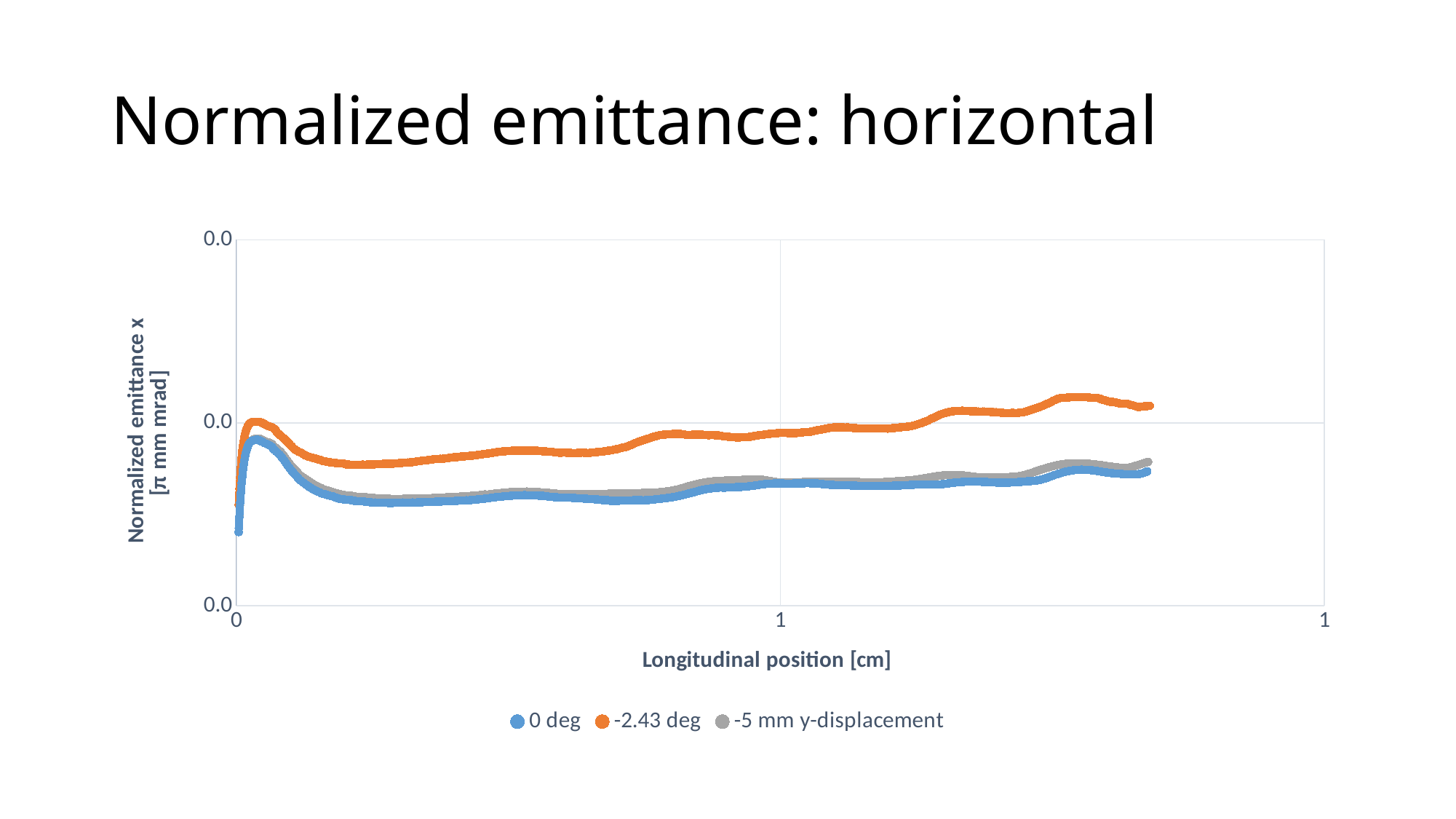
What is the x-axis title of the chart? Longitudinal position [cm] Which series has the highest values across the plotted range? -2.43 deg What is the title of the chart? Normalized emittance: horizontal What kind of chart is shown on the slide? Line chart Which series is higher over most of the plotted range, 0 deg or -2.43 deg? -2.43 deg Which series is higher at the right end of the chart, -2.43 deg or -5 mm y-displacement? -2.43 deg After the initial dip, do the values of the 0 deg series generally rise or fall toward the right end of the chart? Rise After the initial dip, do the values of the -2.43 deg series generally rise or fall as longitudinal position increases? Rise How many series does the legend list? 3